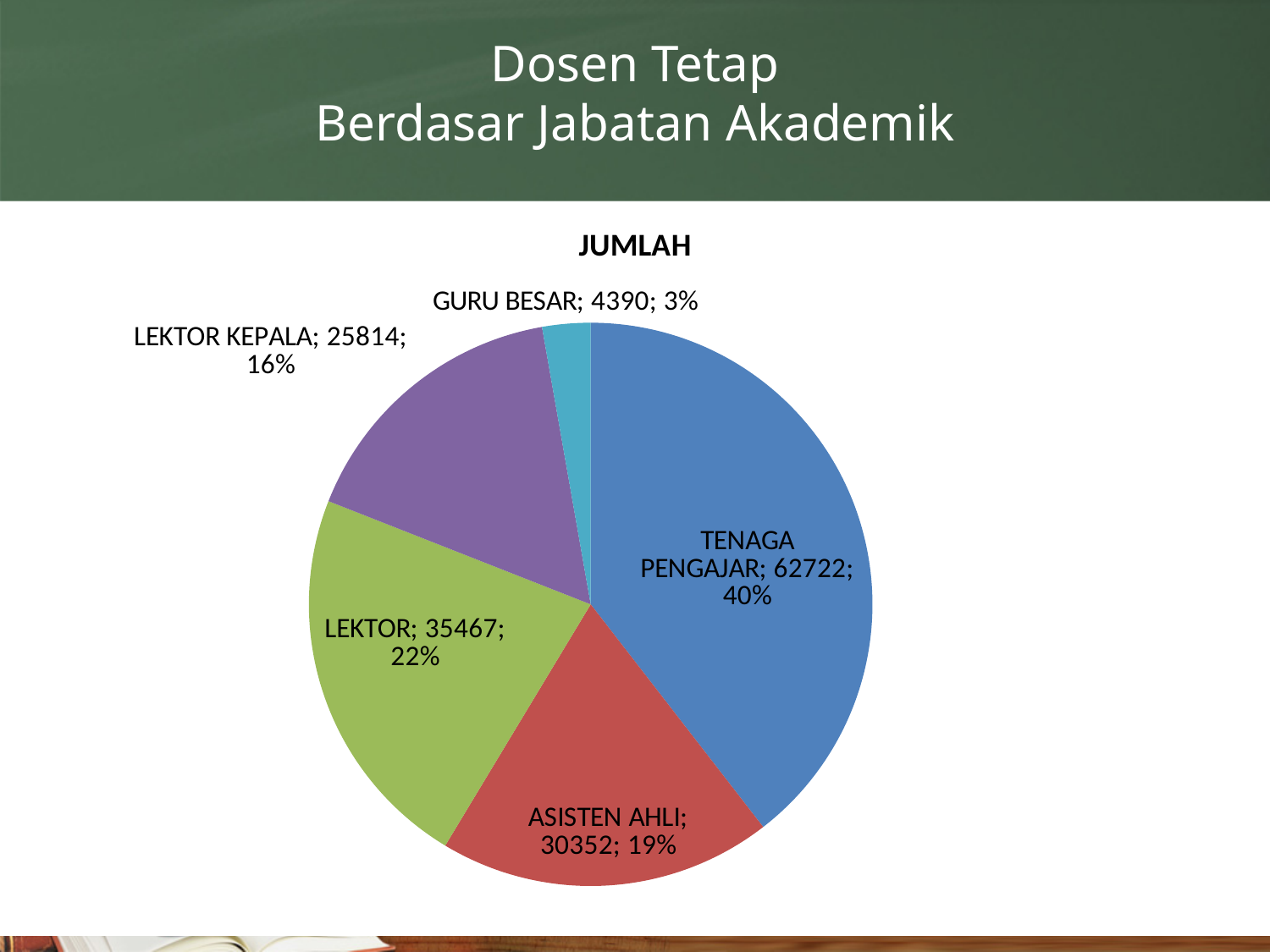
What share of the pie does ASISTEN AHLI represent? 19% Which category has the smallest slice? GURU BESAR Which category has the largest slice? TENAGA PENGAJAR What is the value for TENAGA PENGAJAR? 62722 How many slices does the pie chart have? 5 What type of chart is shown on the slide? pie chart What is the title of the chart? JUMLAH What is the value for GURU BESAR? 4390 What is the value for LEKTOR? 35467 What is the difference between the values for LEKTOR and ASISTEN AHLI? 5115 Which is larger, the value for LEKTOR KEPALA or the value for ASISTEN AHLI? ASISTEN AHLI What share of the pie does LEKTOR KEPALA represent? 16%